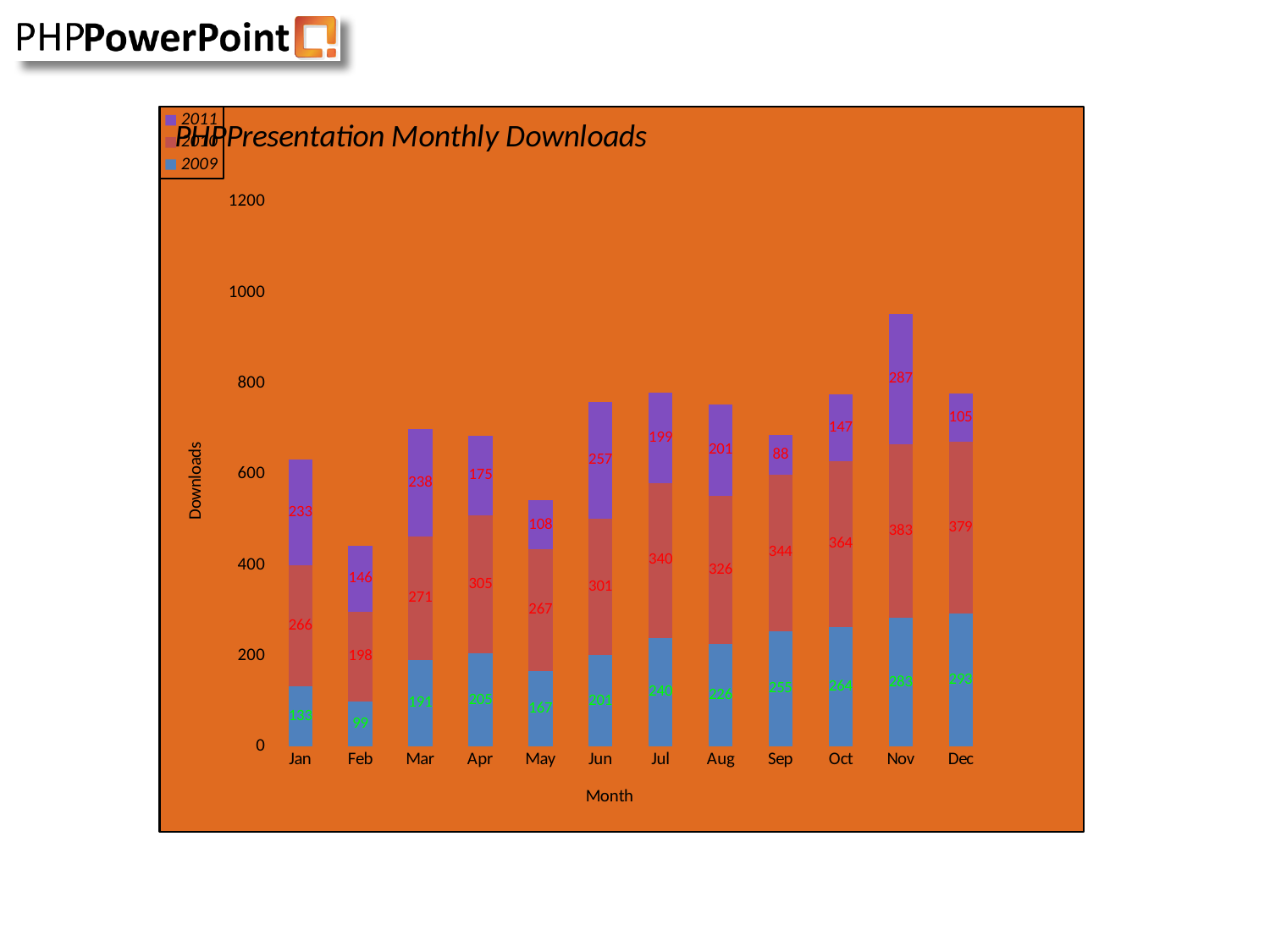
Which month has the lowest 2009 value? Feb Is the total height of the Nov stacked bar greater or less than 800? greater What is the difference between the 2010 value for Dec and the 2010 value for Jan? 113 Which month has the highest 2011 value? Nov What is the 2010 value for Nov? 383 How many series does the legend list? 3 What kind of chart is shown on the slide? stacked bar chart What is the total of the stacked bar for Feb? 443 Which is larger, the 2011 value for Jun or the 2011 value for Mar? Jun What is the 2009 value for Jul? 240 Do the 2010 values generally rise or fall from Jan to Dec? rise How many months are shown on the x axis? 12